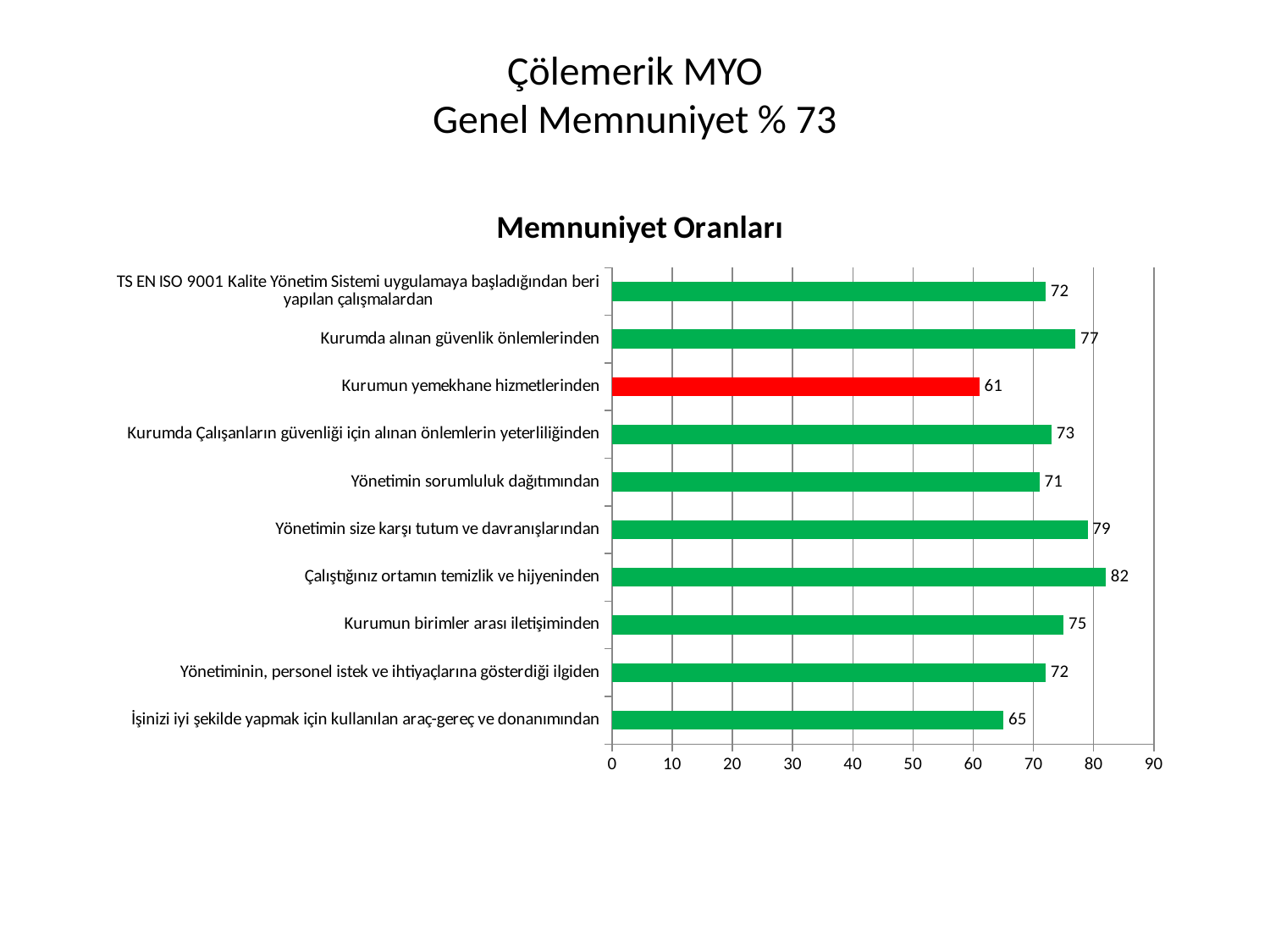
Which is larger: the value for "Yönetimin size karşı tutum ve davranışlarından" or the value for "Kurumun birimler arası iletişiminden"? Yönetimin size karşı tutum ve davranışlarından What is the difference between the values for "Çalıştığınız ortamın temizlik ve hijyeninden" and "Kurumun yemekhane hizmetlerinden"? 21 What is the value for "Çalıştığınız ortamın temizlik ve hijyeninden"? 82 How many categories are shown in the chart? 10 What kind of chart is shown on the slide? bar chart Which category has the lowest value? Kurumun yemekhane hizmetlerinden Is the value for "İşinizi iyi şekilde yapmak için kullanılan araç-gereç ve donanımından" greater or less than 70? less Which category's bar is coloured red instead of green? Kurumun yemekhane hizmetlerinden What is the value for "Kurumun yemekhane hizmetlerinden"? 61 What is the value for "Kurumda alınan güvenlik önlemlerinden"? 77 What is the title of the chart? Memnuniyet Oranları Which category has the highest value? Çalıştığınız ortamın temizlik ve hijyeninden